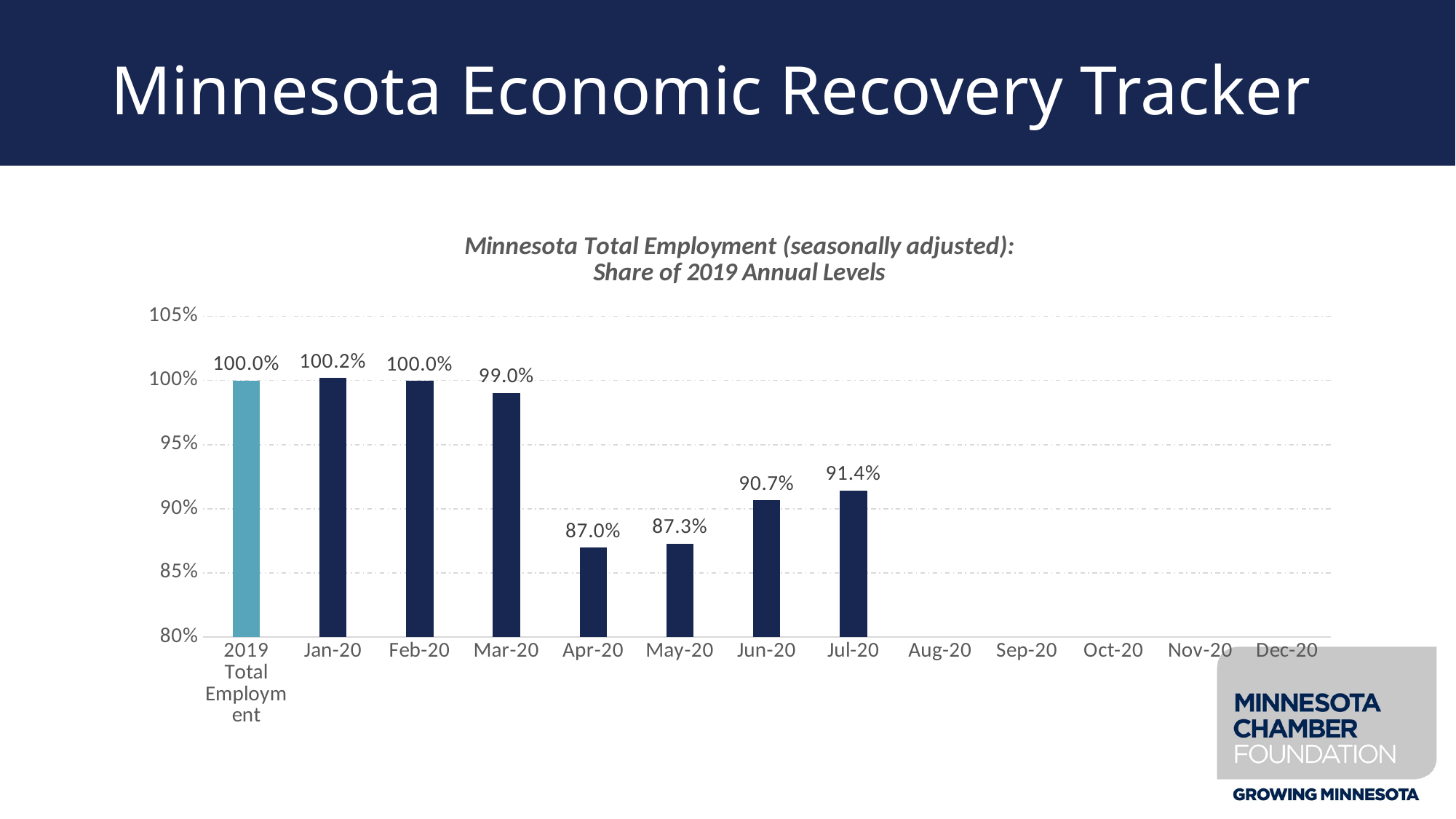
Which is larger, the value for May-20 or the value for Jun-20? Jun-20 What is the title of the chart? Minnesota Total Employment (seasonally adjusted): Share of 2019 Annual Levels What kind of chart is shown? bar chart What is the value for Jul-20? 91.4% Is the value for Jun-20 greater or less than 90%? greater How many bars have data plotted in the chart? 8 Do the values rise or fall from Mar-20 to Apr-20? fall What is the difference between the Jul-20 and Apr-20 values? 4.4% Which month has the lowest value? Apr-20 What is the value for Mar-20? 99.0% What is the value for Apr-20? 87.0% Which category has the highest value? Jan-20